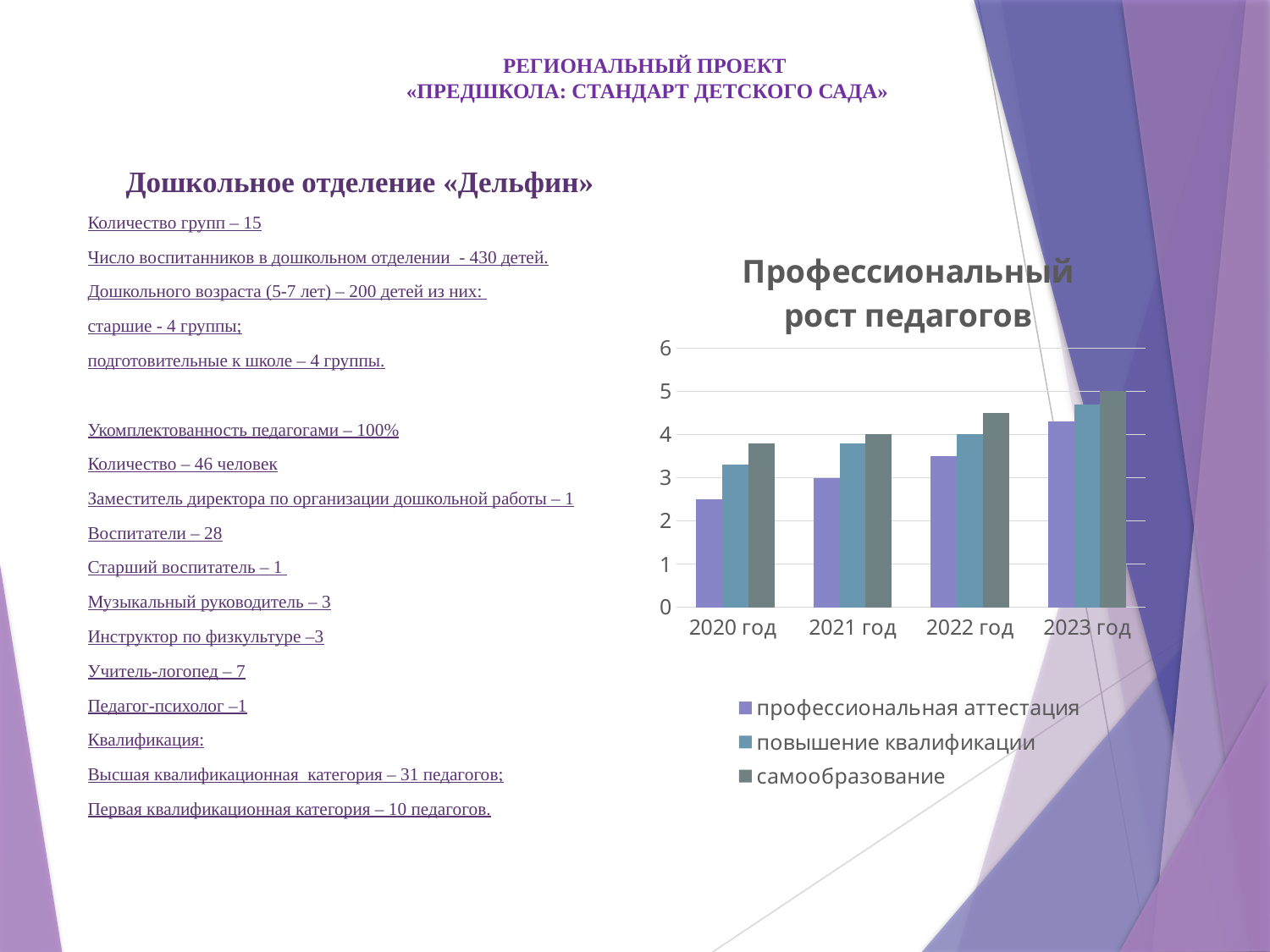
How many series does the chart legend list? 3 Is the value for самообразование in 2020 год greater or less than 4? less Which series is shown in the darkest (grey-green) colour in the chart? самообразование Is the value for самообразование in 2022 год greater or less than 4? greater What is the title of the chart? Профессиональный рост педагогов Is the value for повышение квалификации in 2023 год greater or less than 4? greater How many year categories are shown on the x axis of the chart? 4 What type of chart is shown on the slide? bar chart In which year does самообразование reach its highest value? 2023 год In which year is профессиональная аттестация lowest? 2020 год Does the value for профессиональная аттестация rise or fall from 2020 год to 2023 год? rise